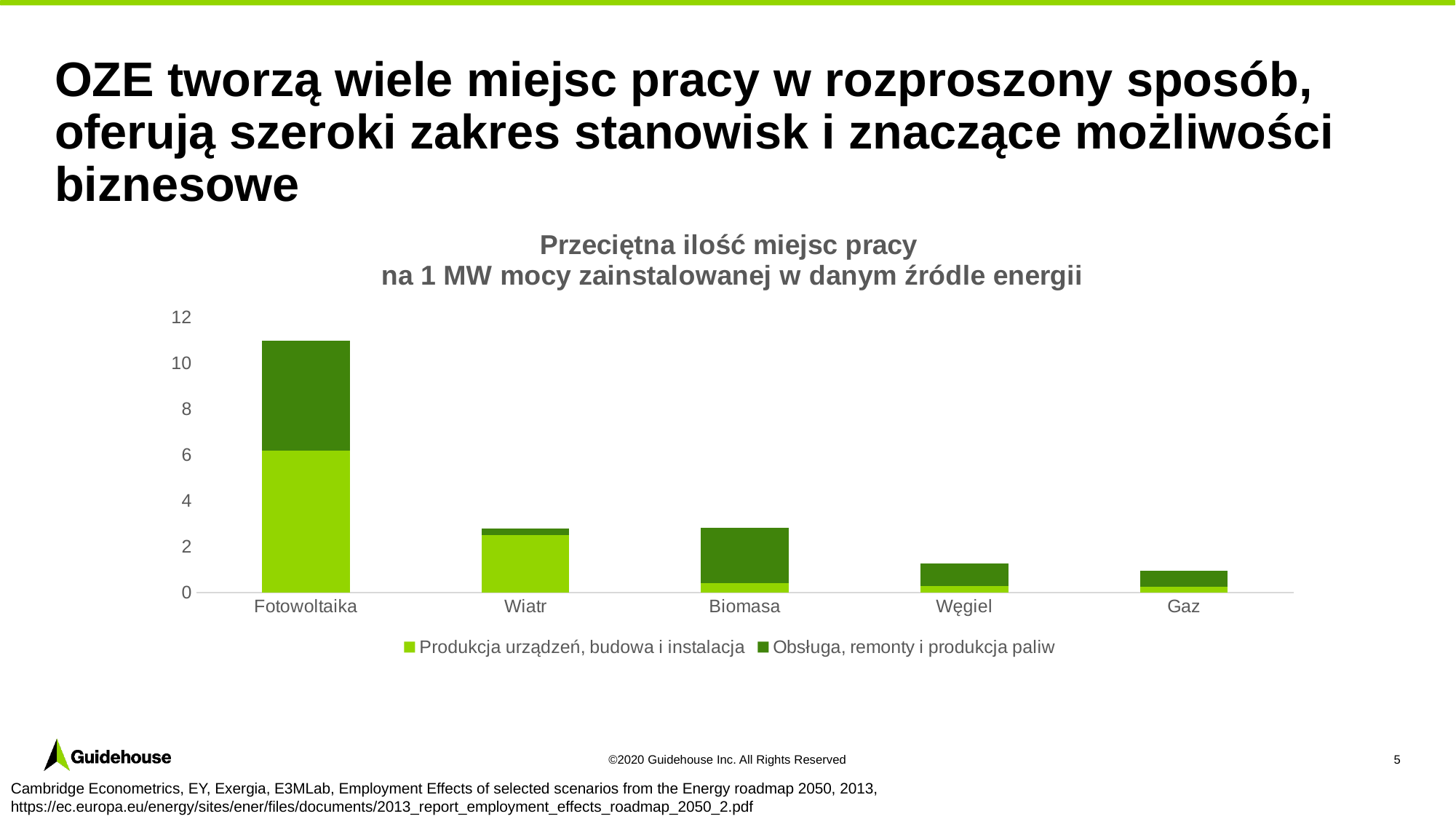
What is the title of the chart? Przeciętna ilość miejsc pracy na 1 MW mocy zainstalowanej w danym źródle energii Is the total value for Wiatr greater or less than 2? greater Is the total value for Węgiel greater or less than 2? less Which energy source has the lowest total number of jobs per 1 MW in the chart? Gaz Is the total value for Biomasa greater or less than 4? less What kind of chart is shown on the slide? Stacked bar chart Which has a larger total value, Fotowoltaika or Wiatr? Fotowoltaika How many series does the chart legend list? 2 Which energy source has the highest total number of jobs per 1 MW in the chart? Fotowoltaika Which has a larger value for 'Produkcja urządzeń, budowa i instalacja', Wiatr or Biomasa? Wiatr How many energy sources are shown on the x axis of the chart? 5